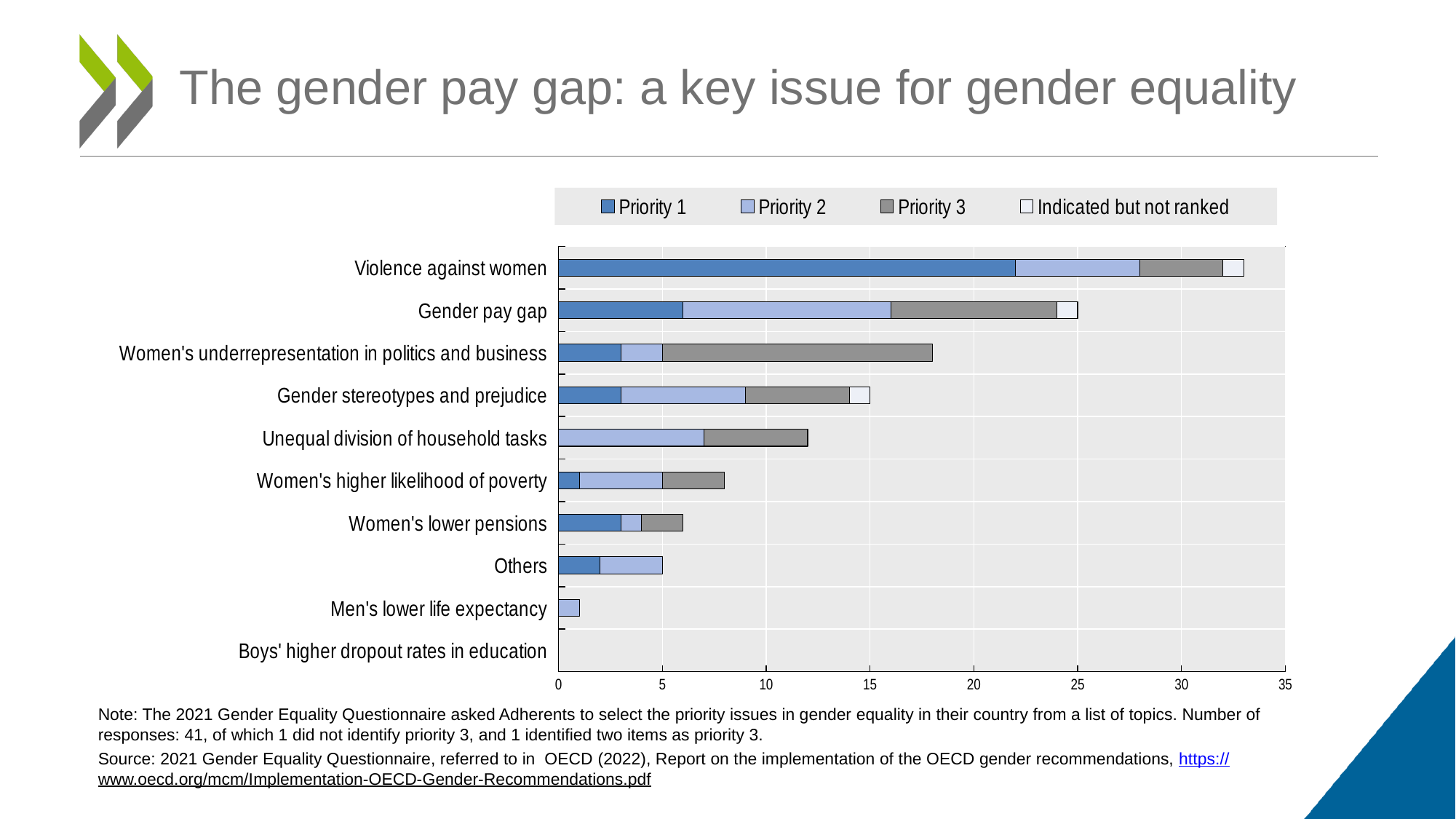
Is the total bar for Gender pay gap greater or less than 20? greater What kind of chart is shown on the slide? Stacked bar chart How many series does the chart legend list? 4 Which has the longer total bar: Unequal division of household tasks or Women's lower pensions? Unequal division of household tasks Is the total bar for Violence against women greater or less than 30? greater What is the last entry listed in the chart legend? Indicated but not ranked Is the total bar for Men's lower life expectancy greater or less than 5? less Which has the longer total bar: Gender pay gap or Gender stereotypes and prejudice? Gender pay gap How many categories are listed on the vertical axis of the chart? 10 Which category has the shortest total bar in the chart? Boys' higher dropout rates in education Which category has the longest total bar in the chart? Violence against women